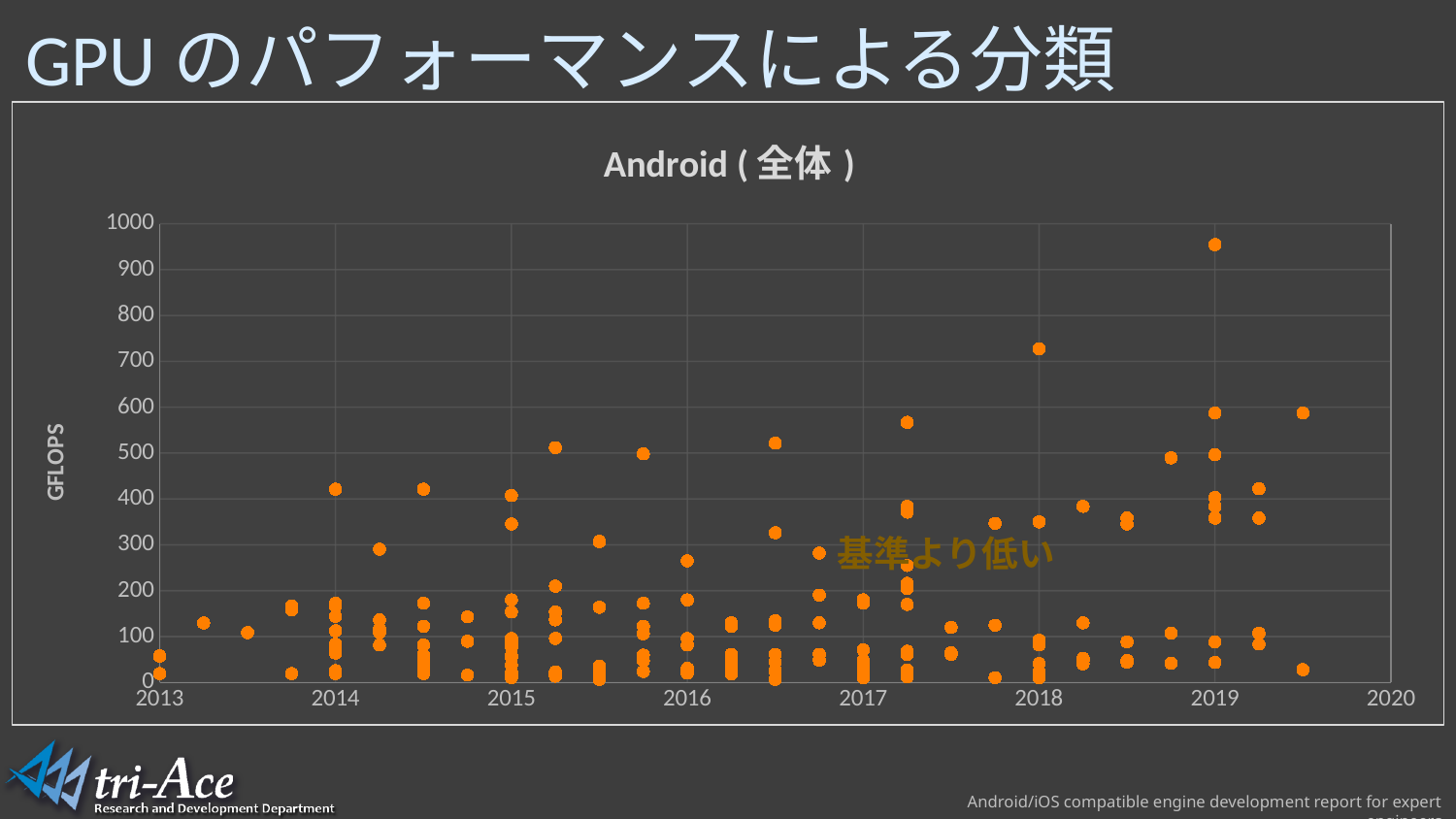
Is the highest point plotted at 2014 greater or less than 300 GFLOPS? greater What is the highest value shown on the vertical axis of the chart? 1000 Is the highest point plotted at 2019 greater or less than 900 GFLOPS? greater What is the label on the vertical axis of the chart? GFLOPS Is the highest point plotted at 2013 greater or less than 100 GFLOPS? less At which year tick is the highest point on the chart plotted? 2019 What is the last year shown on the horizontal axis of the chart? 2020 What is the title of the chart? Android ( 全体 ) Do the maximum GFLOPS values generally rise or fall from 2013 to 2019? rise What kind of chart is shown on the slide? scatter chart What is the first year shown on the horizontal axis of the chart? 2013